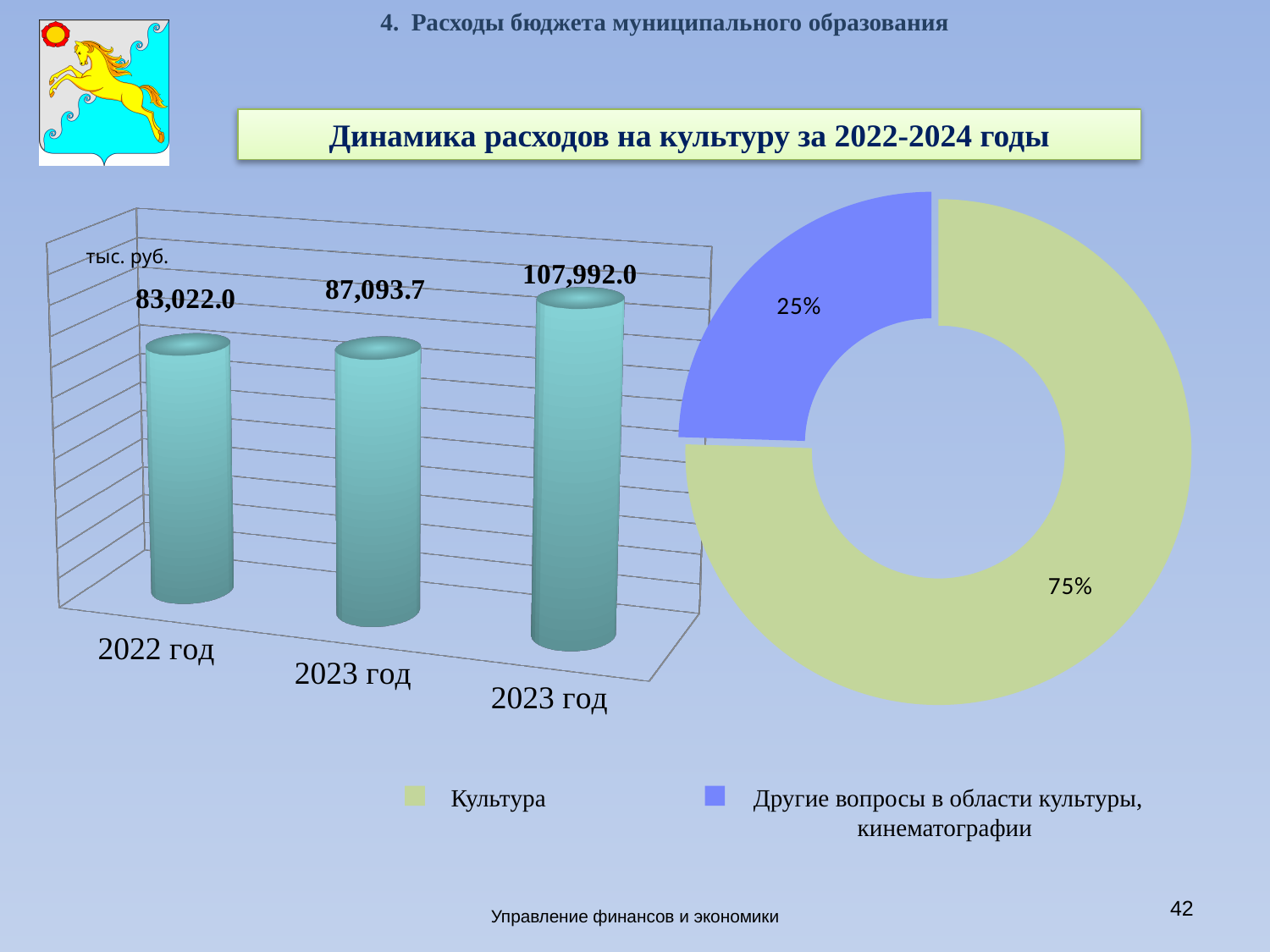
On the doughnut chart on the right, what share does 'Другие вопросы в области культуры, кинематографии' have? 25% On the bar chart on the left, what is the difference between the rightmost bar (107,992.0) and the 2022 год bar? 24,970.0 On the bar chart on the left, what is the value of the rightmost (tallest) bar? 107,992.0 On the bar chart on the left, which bar has the lowest value? 2022 год On the doughnut chart on the right, what share does Культура have? 75% On the bar chart on the left, what is the value of the middle bar? 87,093.7 What kind of chart is on the left side of the slide? bar chart On the bar chart on the left, what is the value for 2022 год? 83,022.0 On the bar chart on the left, what unit is indicated in the top-left corner of the plot area? тыс. руб. How many bars are shown on the bar chart on the left? 3 On the bar chart on the left, do the values rise or fall from left to right? rise On the bar chart on the left, what is the difference between the middle bar and the 2022 год bar? 4,071.7